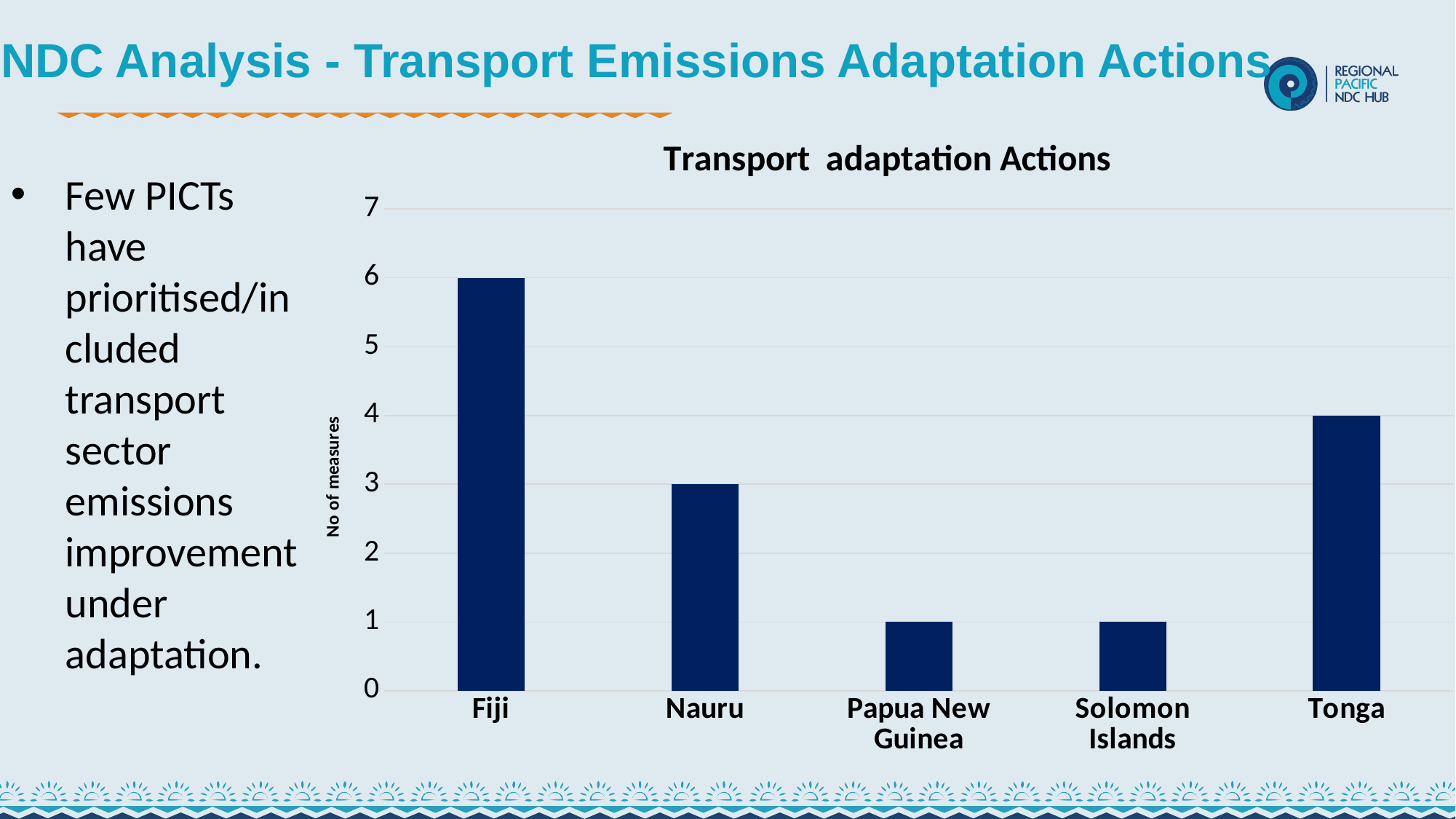
Which country has more measures, Nauru or Tonga? Tonga Which country has the highest number of measures? Fiji What is the number of measures for Papua New Guinea? 1 Is the value for Fiji greater or less than 5? greater What is the label of the y axis? No of measures What is the number of measures for Nauru? 3 What is the title of the chart? Transport adaptation Actions How many countries are shown on the x axis of the chart? 5 What is the number of measures for Tonga? 4 What is the difference in the number of measures between Fiji and Tonga? 2 What is the number of measures for Fiji? 6 What type of chart is shown on the slide? bar chart